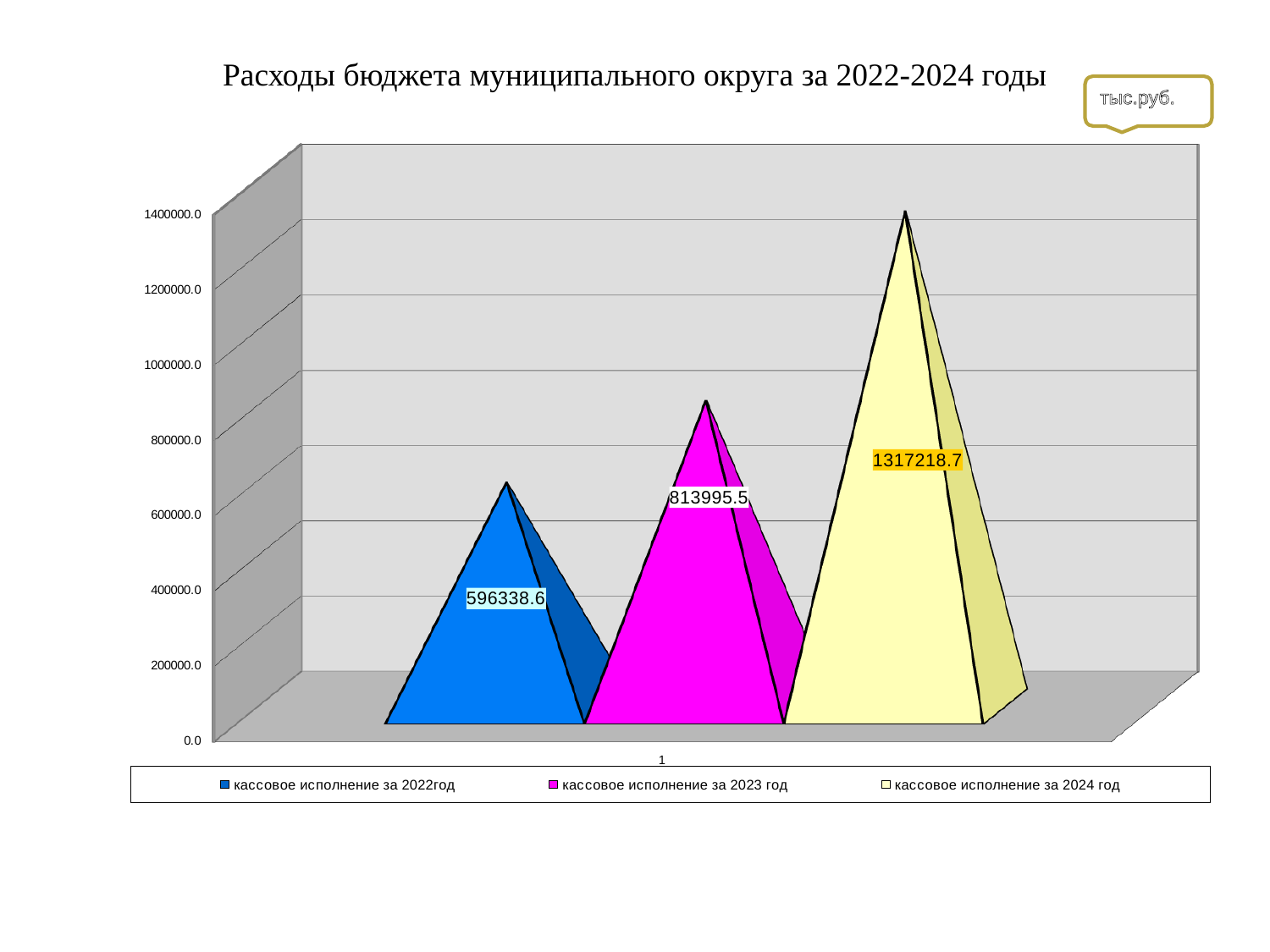
Which is larger, the value for 2022 or the value for 2023? 2023 What is the value for кассовое исполнение за 2024 год? 1317218.7 Which series has the highest value? кассовое исполнение за 2024 год Which series has the lowest value? кассовое исполнение за 2022год What is the title of the chart? Расходы бюджета муниципального округа за 2022-2024 годы How many series does the legend list? 3 What kind of chart is shown on the slide? bar chart What is the difference between the values for 2024 and 2023? 503223.2 What is the difference between the values for 2023 and 2022? 217656.9 What is the value for кассовое исполнение за 2023 год? 813995.5 Is the value for кассовое исполнение за 2024 год greater or less than 1200000.0? greater What is the value for кассовое исполнение за 2022год? 596338.6